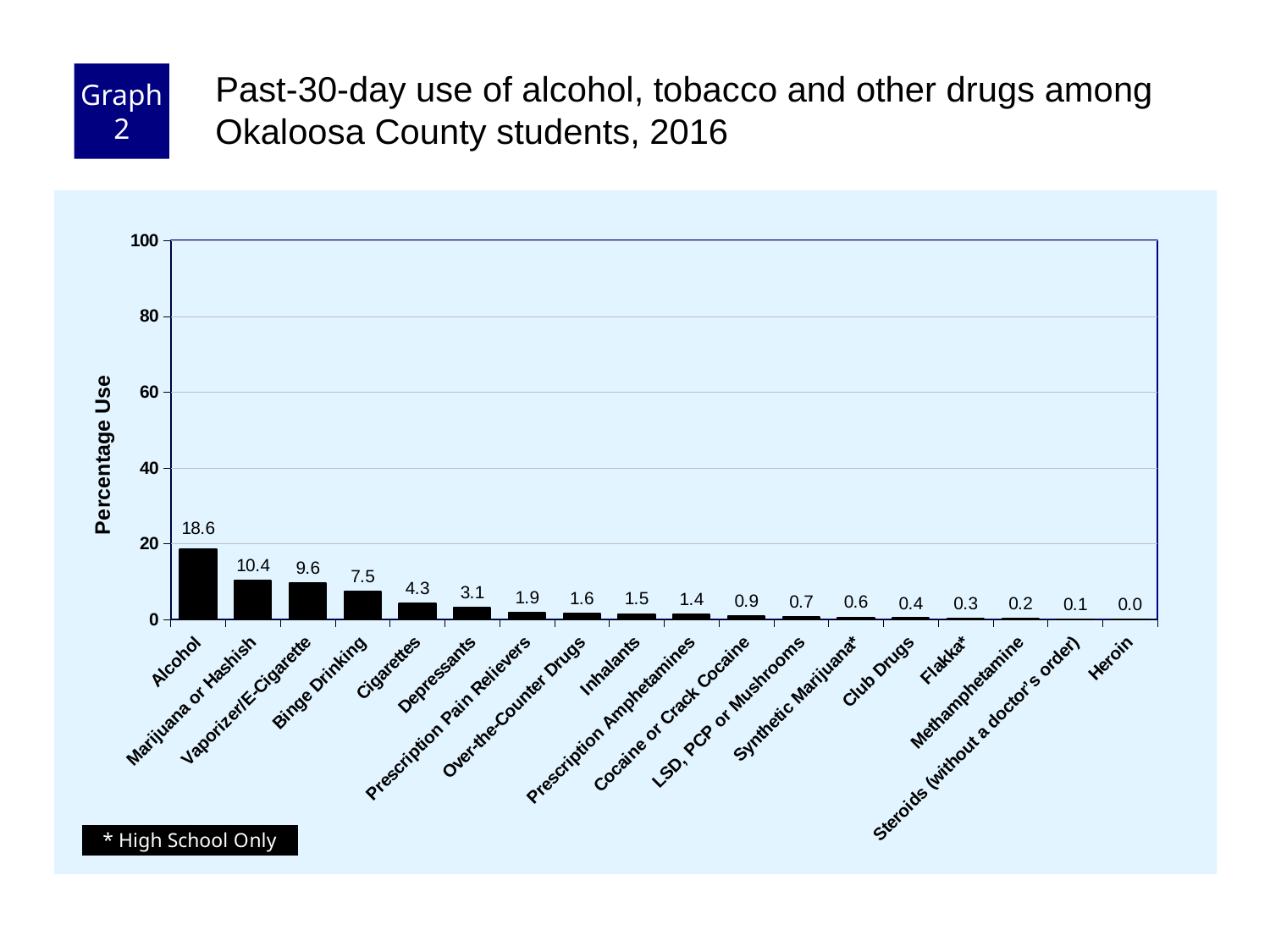
What is the difference in percentage use between Alcohol and Marijuana or Hashish? 8.2 What is the percentage use for Vaporizer/E-Cigarette? 9.6 What is the percentage use for Alcohol? 18.6 What is the difference in percentage use between Binge Drinking and Cigarettes? 3.2 Which category has the highest percentage use? Alcohol How many categories are shown on the x axis? 18 What is the percentage use for Cigarettes? 4.3 Which category has the lowest percentage use? Heroin Do the values rise or fall moving from left to right along the x axis? Fall Which has a higher percentage use, Depressants or Inhalants? Depressants What kind of chart is shown on the slide? Bar chart What is the percentage use for Synthetic Marijuana*? 0.6